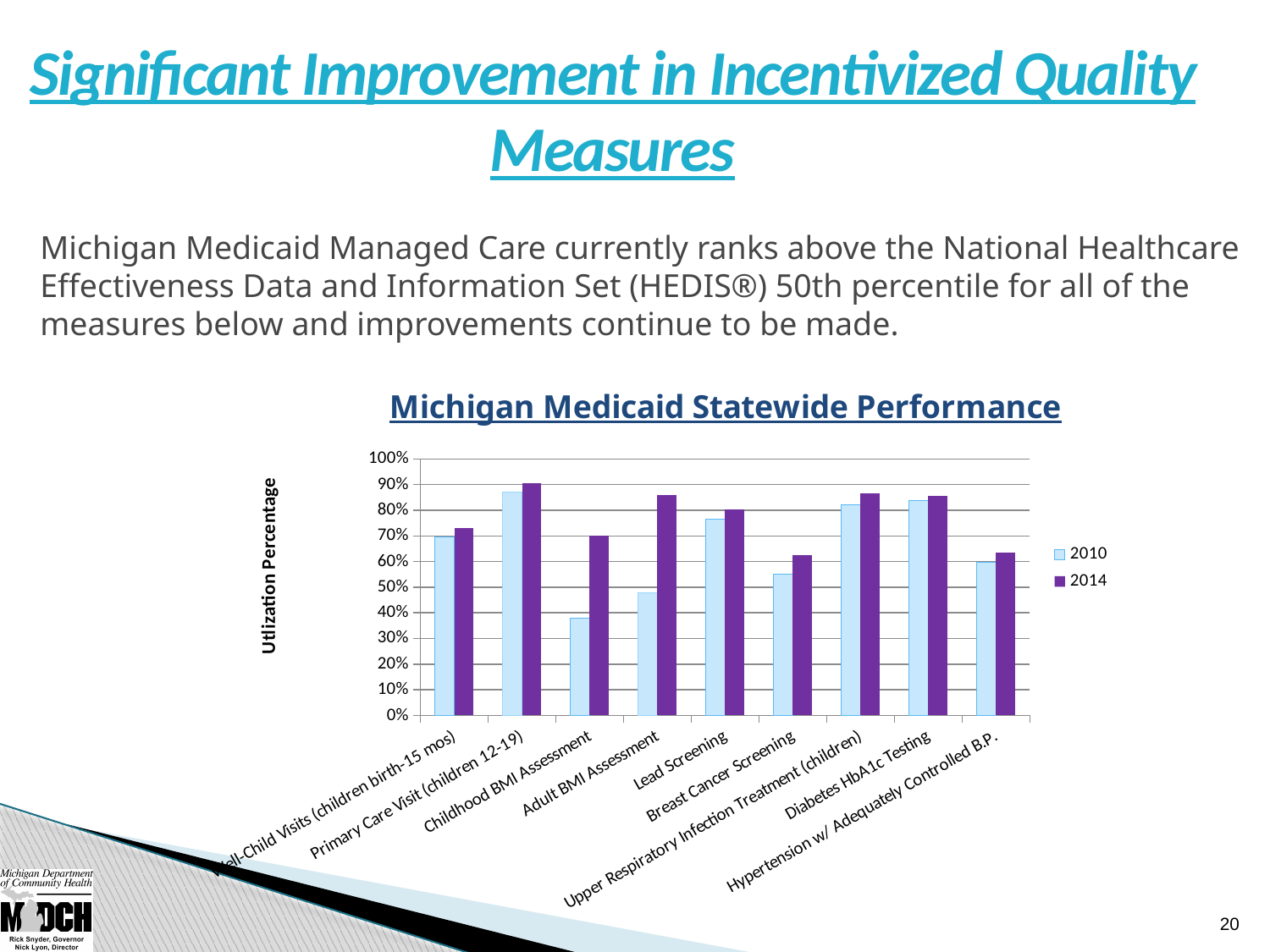
How many quality measures (categories) are shown on the x axis of the chart? 9 What kind of chart is shown under the title "Michigan Medicaid Statewide Performance"? Bar chart For Childhood BMI Assessment, which year has the larger value, 2010 or 2014? 2014 Is the 2010 value for Childhood BMI Assessment greater or less than 50%? less Is the 2014 value for Adult BMI Assessment greater or less than 80%? greater Which years are listed in the chart's legend? 2010 and 2014 Which measure has the highest 2014 value in the chart? Primary Care Visit (children 12-19) Which measure has the lowest 2010 value in the chart? Childhood BMI Assessment What is the label of the chart's vertical axis? Utlization Percentage Is the 2010 value for Breast Cancer Screening greater or less than 60%? less In 2010, which is larger: the value for Adult BMI Assessment or the value for Lead Screening? Lead Screening How many series does the legend of the chart list? 2